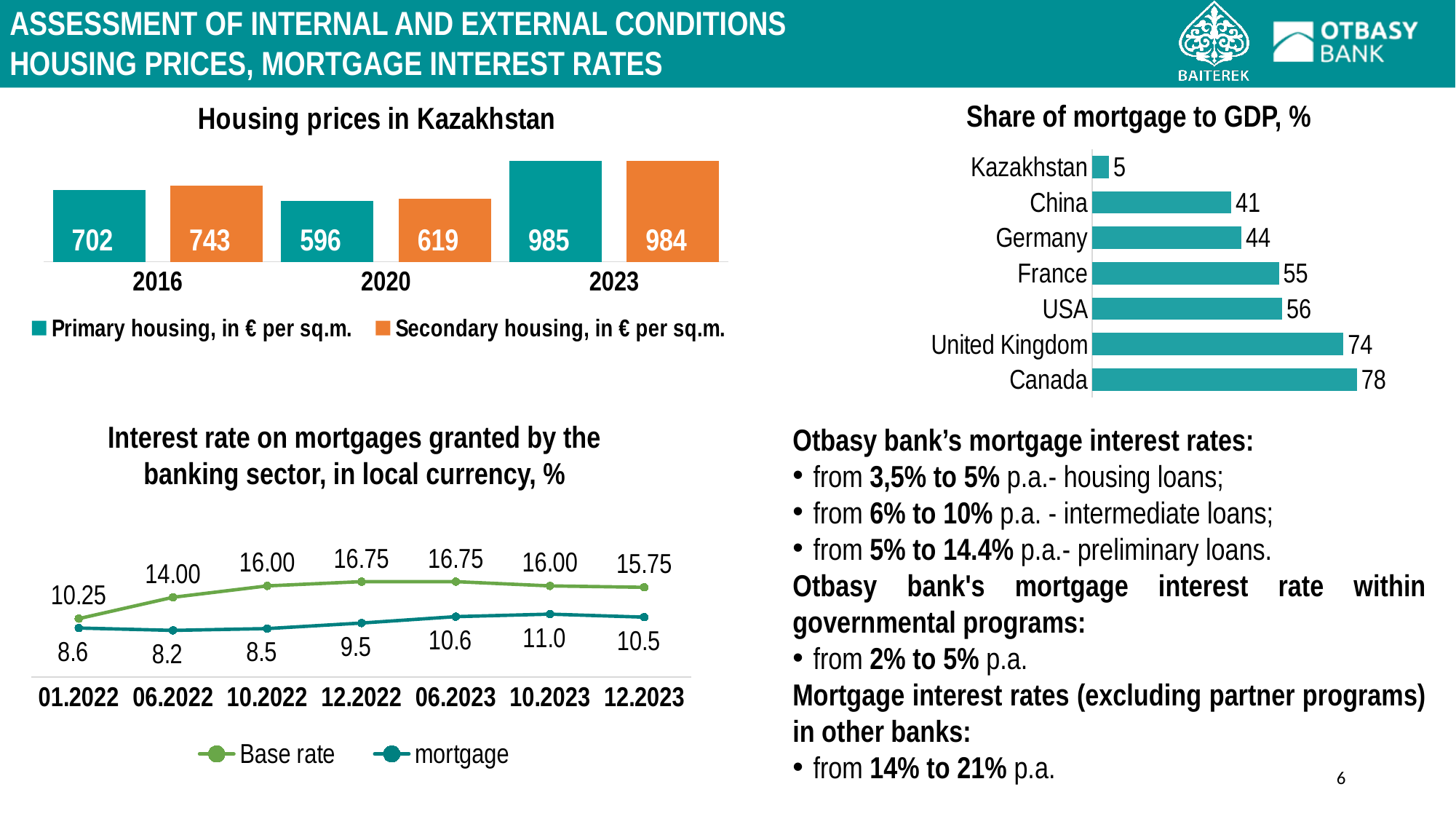
In the 'Housing prices in Kazakhstan' chart, what is the value for primary housing in 2023? 985 In the 'Interest rate on mortgages granted by the banking sector' chart, what is the difference between the base rate and the mortgage rate at 12.2022? 7.25 In the 'Share of mortgage to GDP, %' chart, how many countries are shown? 7 In the 'Share of mortgage to GDP, %' chart, which country has the highest share? Canada In the 'Housing prices in Kazakhstan' chart, what is the value for secondary housing in 2016? 743 In the 'Housing prices in Kazakhstan' chart, what is the difference between secondary and primary housing prices in 2020? 23 In the 'Housing prices in Kazakhstan' chart, which year has the lowest primary housing price? 2020 What kind of chart is the 'Share of mortgage to GDP, %' chart? Bar chart How many series does the legend of the 'Housing prices in Kazakhstan' chart list? 2 In the 'Share of mortgage to GDP, %' chart, what is the difference between the United Kingdom and Kazakhstan? 69 In the 'Interest rate on mortgages granted by the banking sector' chart, what is the mortgage rate at 10.2023? 11.0 In the 'Share of mortgage to GDP, %' chart, what is the value for Germany? 44